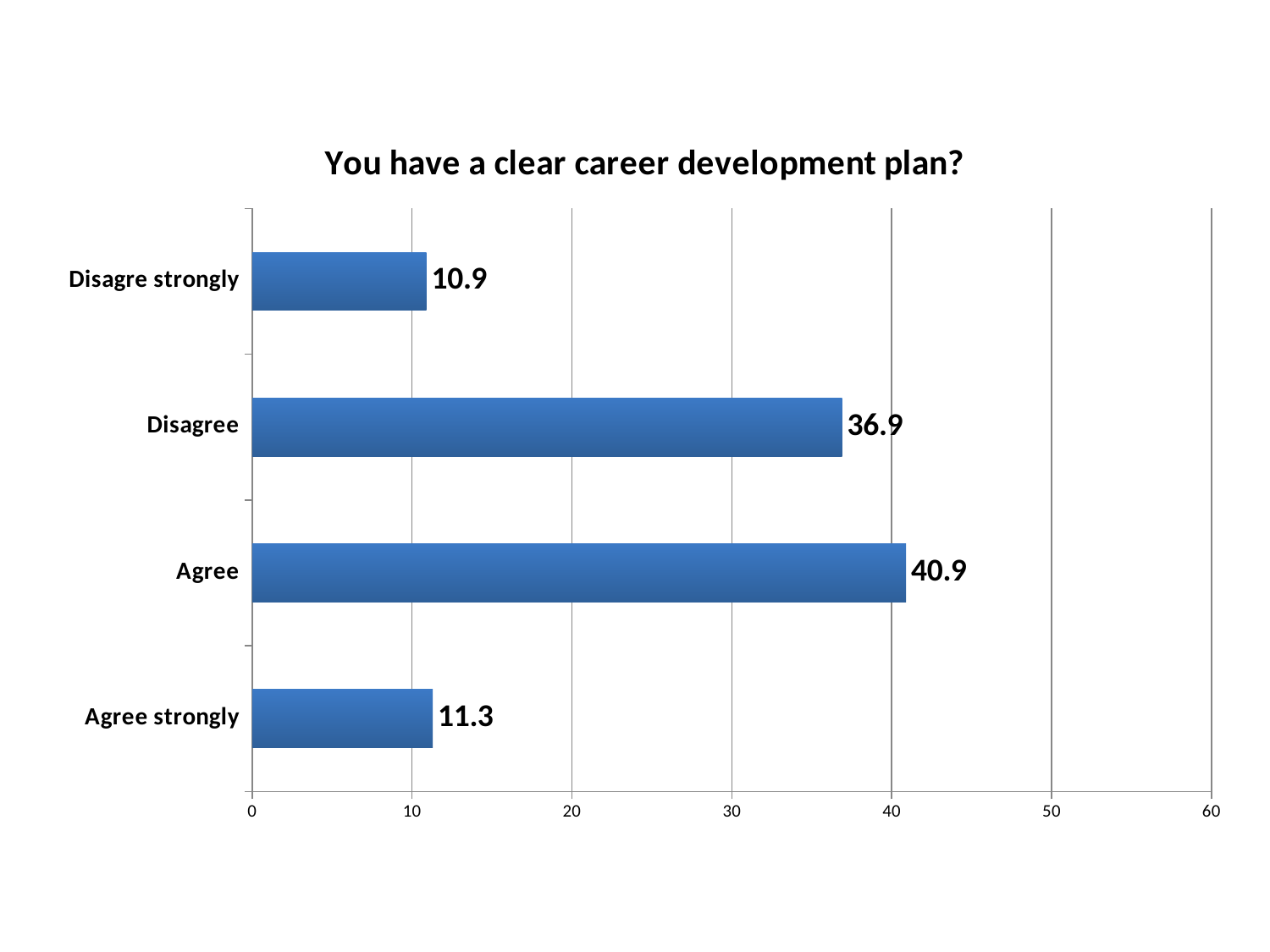
Which category has the highest value? Agree What is the value for Agree strongly? 11.3 Is the value for Disagree greater or less than 30? greater What is the difference between the values for Agree and Disagree? 4.0 What is the value for Agree? 40.9 What is the value for Disagree? 36.9 What is the difference between the values for Agree strongly and Disagre strongly? 0.4 Which category has the lowest value? Disagre strongly What kind of chart is shown on the slide? bar chart What is the value for Disagre strongly? 10.9 How many categories are shown in the chart? 4 Which is larger, the value for Agree or the value for Disagree? Agree